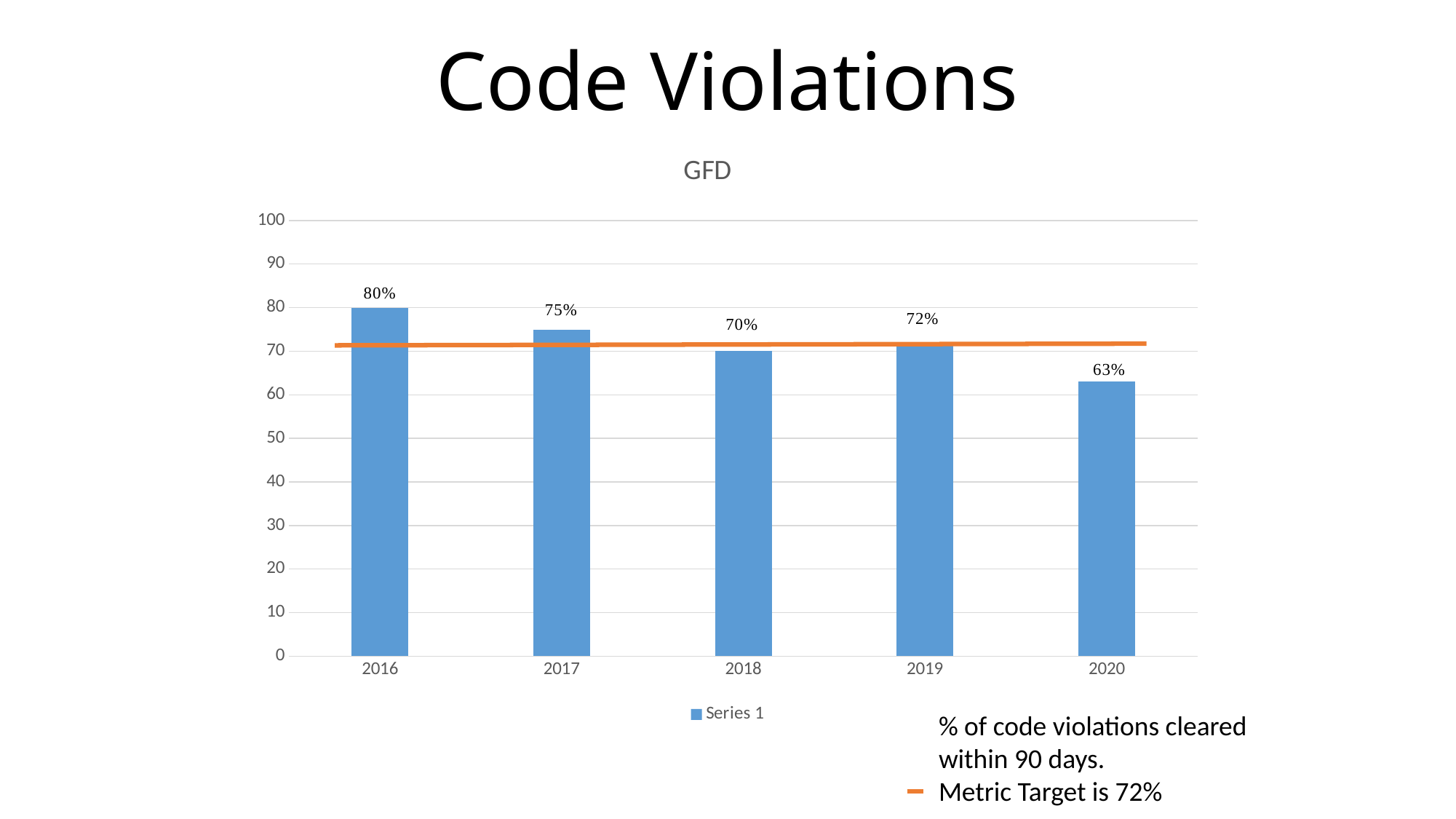
Which is larger, the value for 2017 or the value for 2019? 2017 What is the title of the chart? GFD How many series does the legend list? 1 What is the value for 2020? 63% What is the value for 2016? 80% What is the value for 2018? 70% What kind of chart is shown? bar chart How many years are shown on the x axis? 5 Is the value for 2018 greater or less than 80? less What is the difference between the values for 2016 and 2020? 17% Which year has the highest value? 2016 Which year has the lowest value? 2020